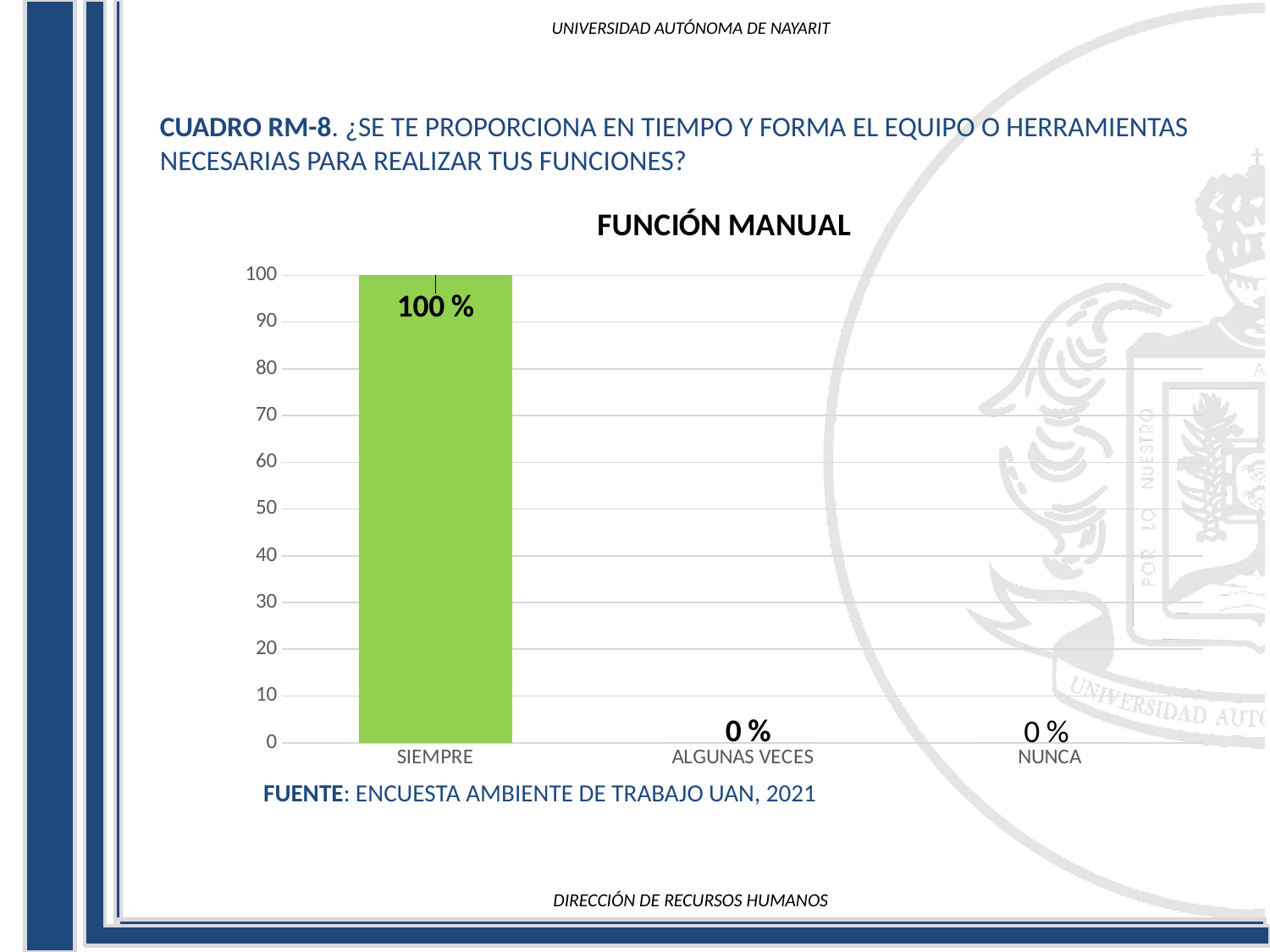
What is the value for ALGUNAS VECES? 0 % What is the title of the chart? FUNCIÓN MANUAL Do the values rise or fall from SIEMPRE to NUNCA along the x axis? fall What is the difference between the values for SIEMPRE and ALGUNAS VECES? 100 % Which category has the highest value? SIEMPRE Which is larger, the value for SIEMPRE or the value for NUNCA? SIEMPRE What is the value for NUNCA? 0 % What colour is the bar for SIEMPRE? green What is the value for SIEMPRE? 100 % What kind of chart is shown on the slide? bar chart Is the value for SIEMPRE greater or less than 50? greater How many categories are shown on the x axis? 3